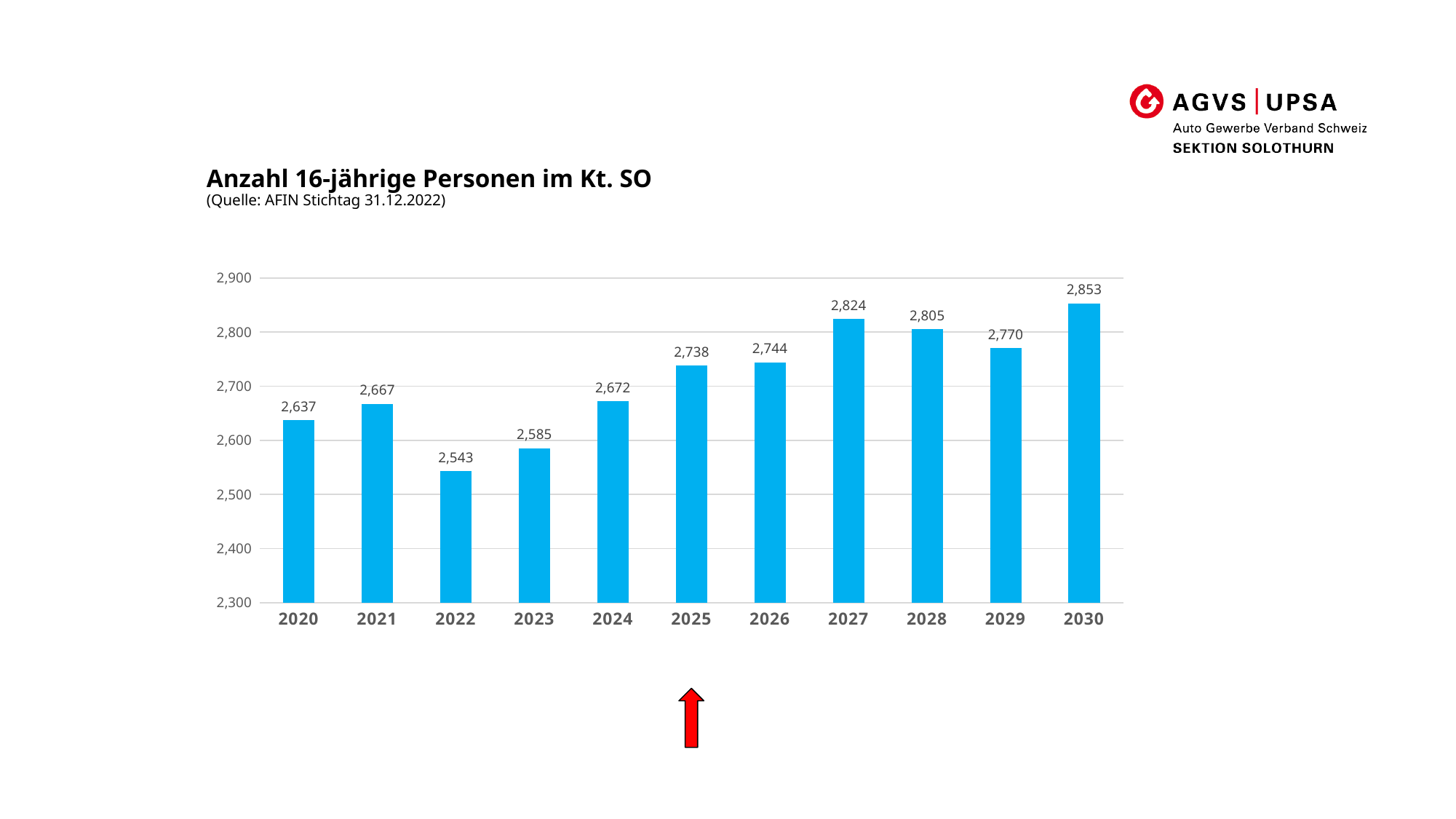
Which is larger, the value for 2021 or the value for 2024? 2024 What is the difference between the values for 2027 and 2028? 19 Which year has the highest value? 2030 What kind of chart is shown? bar chart Is the value for 2029 greater or less than 2,800? less What is the value for 2030? 2,853 What is the difference between the values for 2030 and 2022? 310 How many years are shown on the x axis? 11 Which year has the lowest value? 2022 What is the title of the chart? Anzahl 16-jährige Personen im Kt. SO What is the value for 2025? 2,738 What is the value for 2022? 2,543